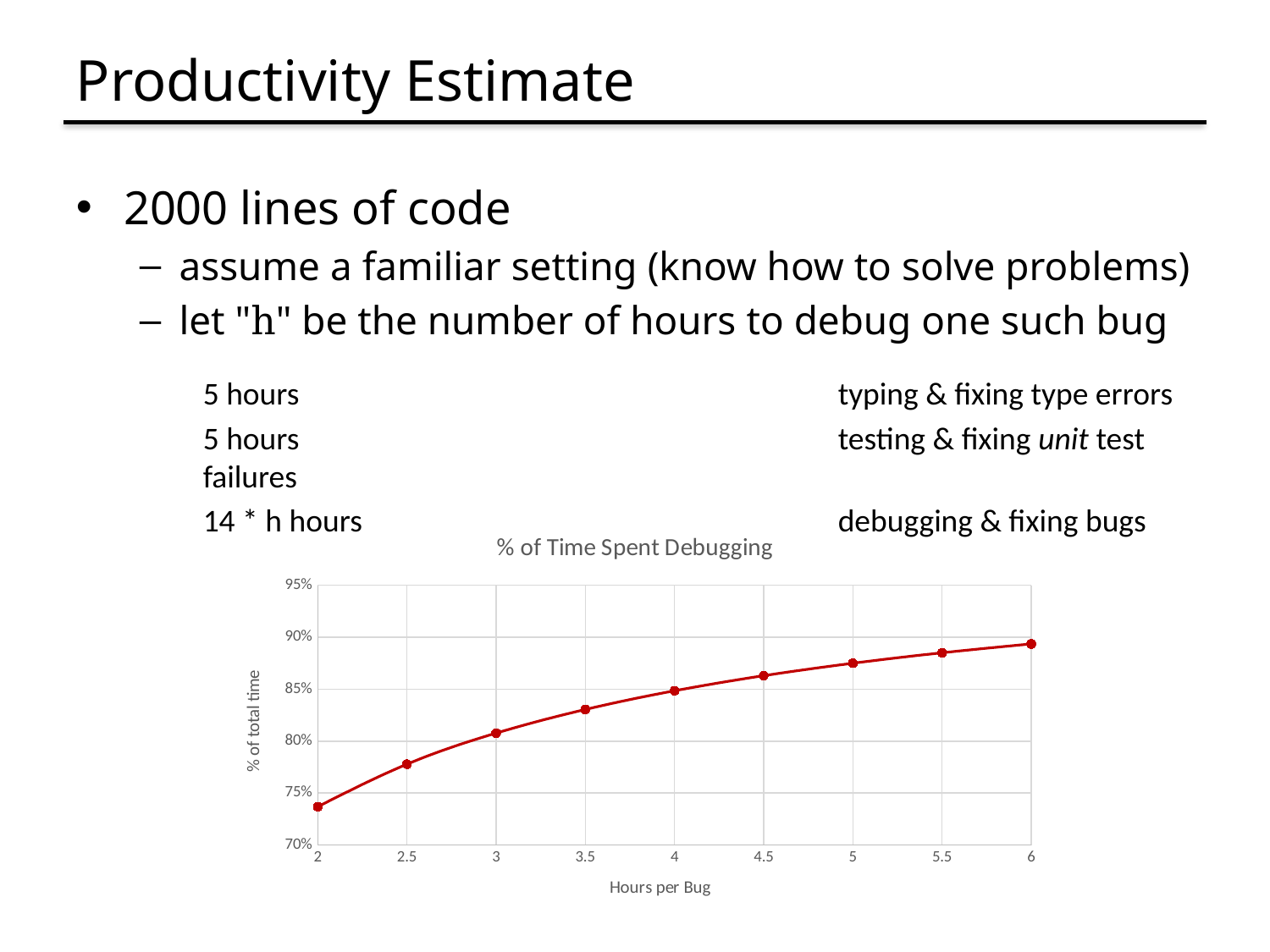
What kind of chart is shown on the slide? line chart Which is larger, the value at 3 hours per bug or the value at 5 hours per bug? 5 hours per bug What is the label of the x axis of the chart? Hours per Bug At which Hours per Bug value is the % of total time lowest? 2 What is the title of the chart? % of Time Spent Debugging Is the value at 2.5 hours per bug greater or less than 75%? greater Is the value at 5 hours per bug greater or less than 85%? greater At which Hours per Bug value is the % of total time highest? 6 Do the values rise or fall as Hours per Bug increases along the x axis? rise How many data points are plotted on the chart? 9 Is the value at 2 hours per bug greater or less than 75%? less